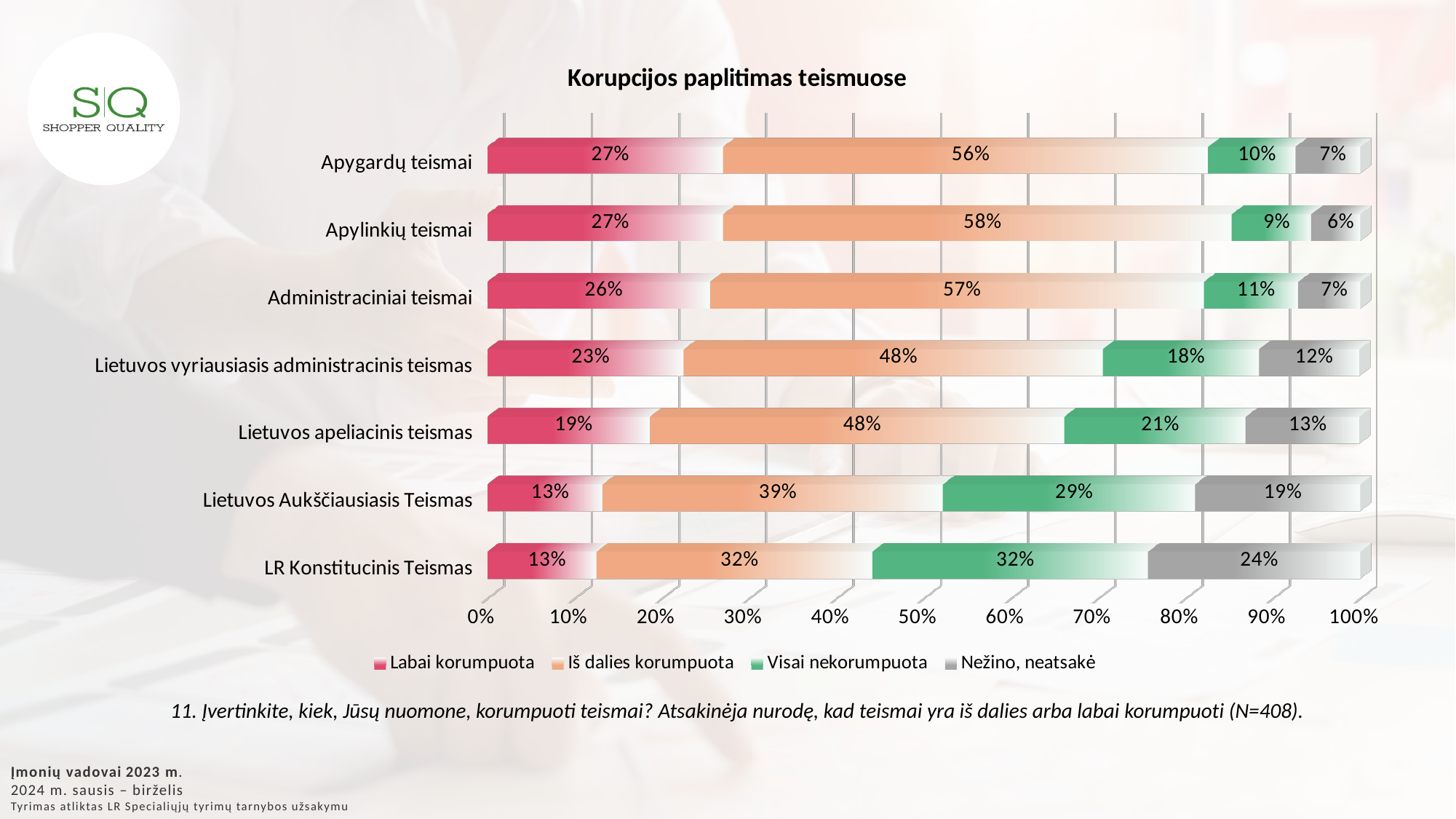
What is the difference between the "Iš dalies korumpuota" values for Apygardų teismai and LR Konstitucinis Teismas? 24% Which court has the highest "Visai nekorumpuota" value? LR Konstitucinis Teismas Which court has the lowest "Nežino, neatsakė" value? Apylinkių teismai How many series does the legend list? 4 What is the value of "Nežino, neatsakė" for LR Konstitucinis Teismas? 24% What is the value of "Visai nekorumpuota" for Lietuvos Aukščiausiasis Teismas? 29% How many courts (categories) are shown in the chart? 7 What kind of chart is shown on the slide? Stacked bar chart What is the title of the chart? Korupcijos paplitimas teismuose What is the value of "Iš dalies korumpuota" for Apylinkių teismai? 58% What is the value of "Labai korumpuota" for Apygardų teismai? 27% Which is larger: the "Visai nekorumpuota" value for Lietuvos apeliacinis teismas or for Lietuvos vyriausiasis administracinis teismas? Lietuvos apeliacinis teismas